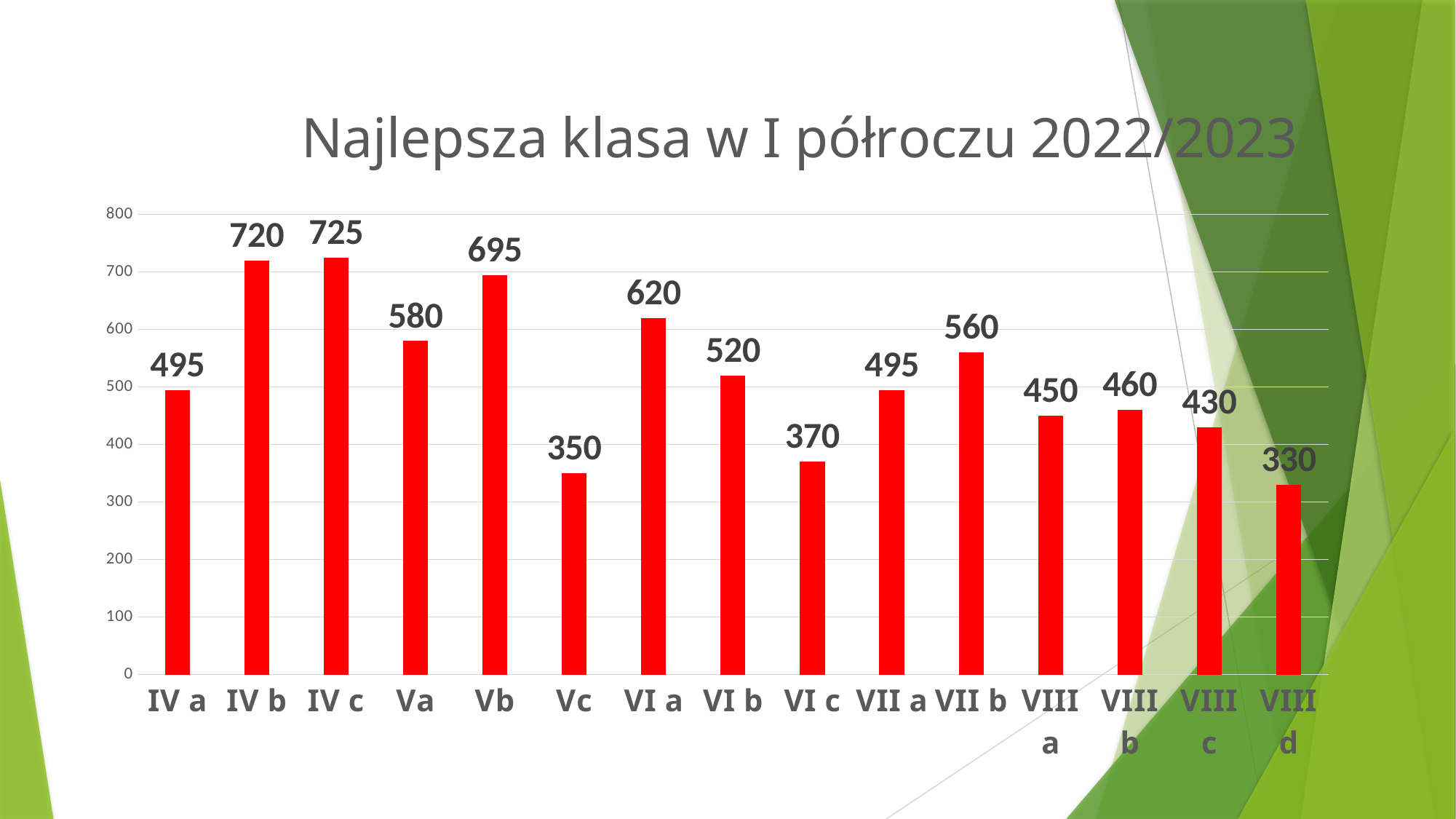
What is the difference between the values for VI a and VI c? 250 Which class has the lowest value? VIII d Is the value for Va greater or less than 500? greater What is the difference between the values for Vb and Vc? 345 Which is larger, the value for VII b or the value for VIII b? VII b What is the title of the chart? Najlepsza klasa w I półroczu 2022/2023 What kind of chart is shown on the slide? bar chart Which class has the highest value? IV c What is the value for IV b? 720 What is the value for VIII d? 330 How many classes are shown on the chart? 15 What is the value for Vc? 350